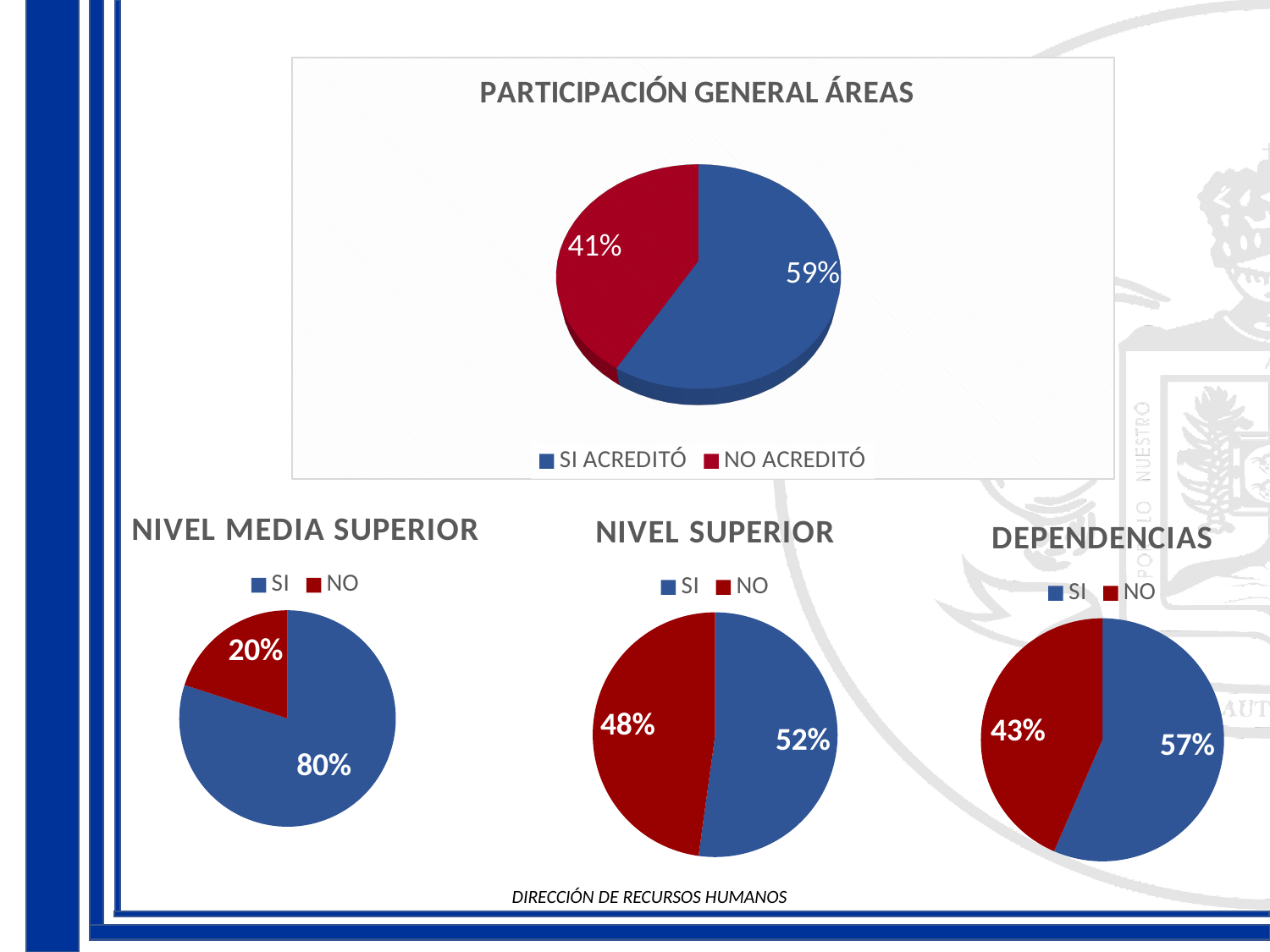
In the NIVEL MEDIA SUPERIOR chart, what share is labelled for NO? 20% In the PARTICIPACIÓN GENERAL ÁREAS chart, what share is labelled for NO ACREDITÓ? 41% In the NIVEL SUPERIOR chart, what share is labelled for NO? 48% In the DEPENDENCIAS chart, what is the difference between the SI and NO shares? 14% In the PARTICIPACIÓN GENERAL ÁREAS chart, which slice is larger, SI ACREDITÓ or NO ACREDITÓ? SI ACREDITÓ In the NIVEL MEDIA SUPERIOR chart, what is the difference between the SI and NO shares? 60% What kind of chart is the PARTICIPACIÓN GENERAL ÁREAS chart? Pie chart How many entries does the legend of the PARTICIPACIÓN GENERAL ÁREAS chart list? 2